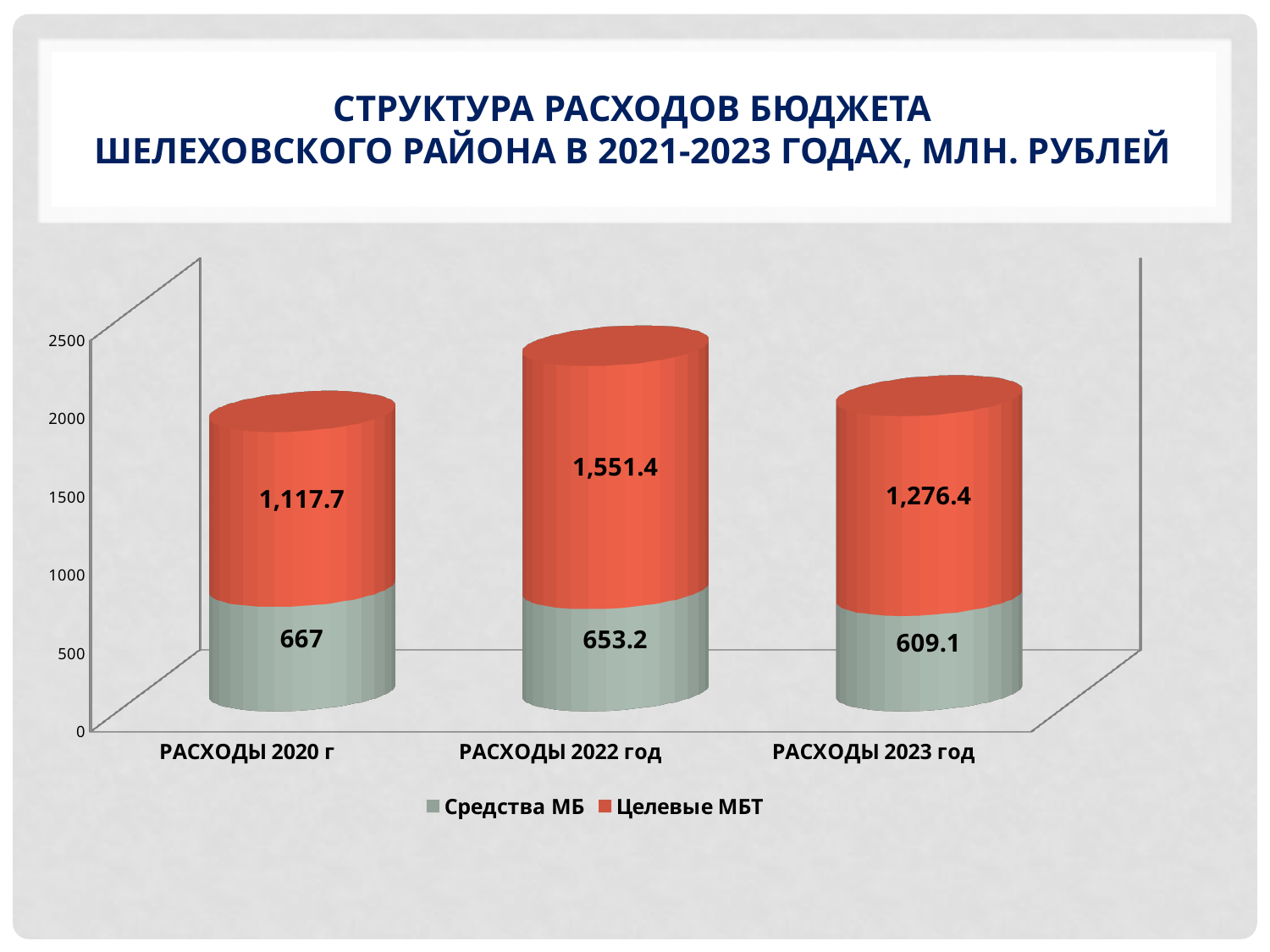
What is the value of Целевые МБТ for РАСХОДЫ 2023 год? 1,276.4 How many series does the legend list? 2 What is the value of Средства МБ for РАСХОДЫ 2023 год? 609.1 In which category is Средства МБ the lowest? РАСХОДЫ 2023 год What is the value of Средства МБ for РАСХОДЫ 2020 г? 667 What is the difference between Целевые МБТ for РАСХОДЫ 2022 год and РАСХОДЫ 2020 г? 433.7 What is the total of the stacked bar for РАСХОДЫ 2022 год? 2,204.6 What type of chart is shown on the slide? stacked bar chart How many categories are shown on the x axis? 3 What is the value of Целевые МБТ for РАСХОДЫ 2022 год? 1,551.4 In which category is Целевые МБТ the highest? РАСХОДЫ 2022 год Which is larger: Средства МБ for РАСХОДЫ 2020 г or for РАСХОДЫ 2022 год? РАСХОДЫ 2020 г